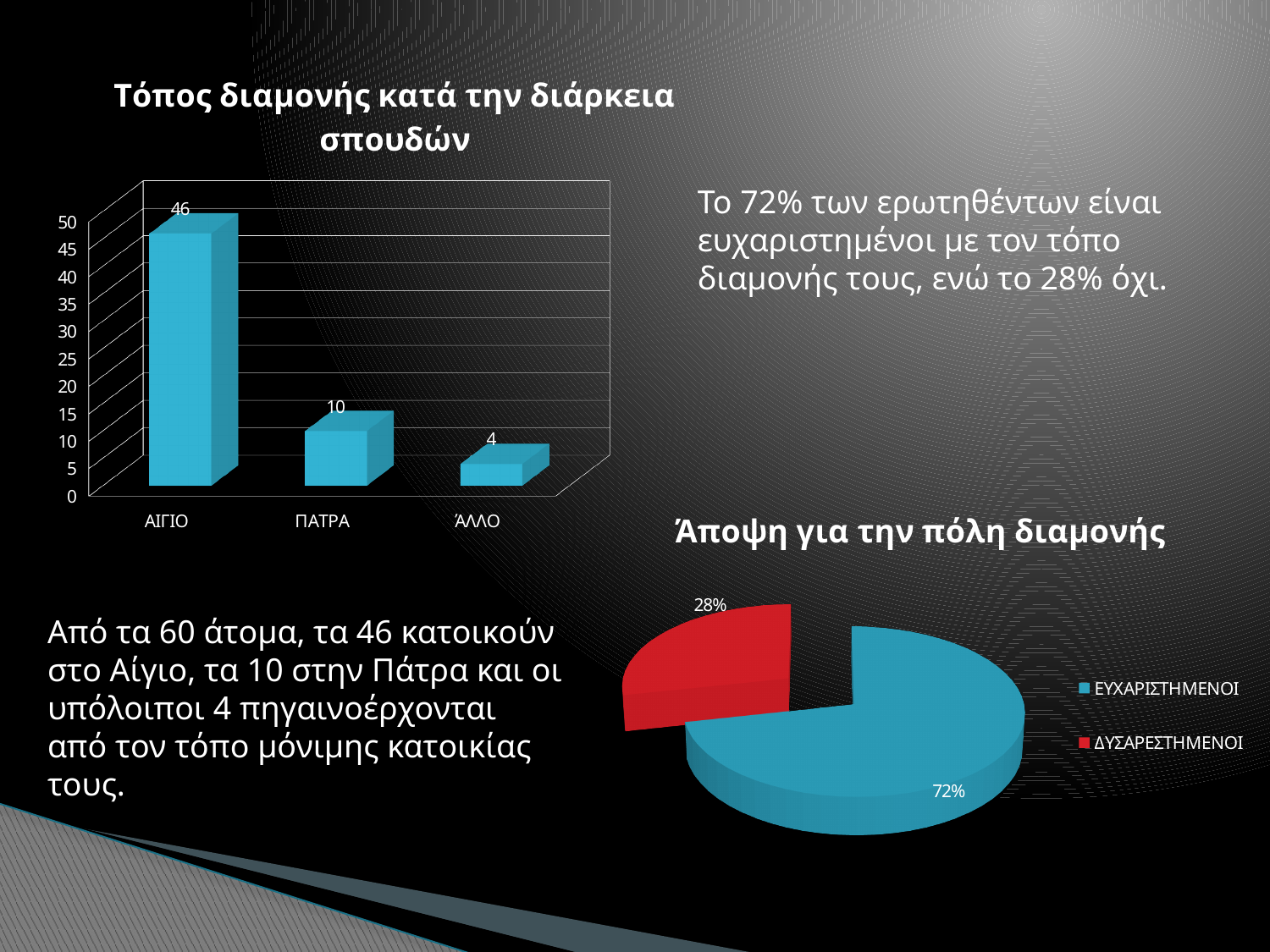
In the pie chart 'Άποψη για την πόλη διαμονής', which slice is larger, ΕΥΧΑΡΙΣΤΗΜΕΝΟΙ or ΔΥΣΑΡΕΣΤΗΜΕΝΟΙ? ΕΥΧΑΡΙΣΤΗΜΕΝΟΙ In the bar chart 'Τόπος διαμονής κατά την διάρκεια σπουδών', which category has the lowest value? ΆΛΛΟ In the pie chart 'Άποψη για την πόλη διαμονής', what colour is the ΔΥΣΑΡΕΣΤΗΜΕΝΟΙ slice? red In the bar chart 'Τόπος διαμονής κατά την διάρκεια σπουδών', what is the value for ΠΑΤΡΑ? 10 In the pie chart 'Άποψη για την πόλη διαμονής', what share is ΕΥΧΑΡΙΣΤΗΜΕΝΟΙ? 72% In the bar chart 'Τόπος διαμονής κατά την διάρκεια σπουδών', what is the difference between the values for ΑΙΓΙΟ and ΠΑΤΡΑ? 36 In the bar chart 'Τόπος διαμονής κατά την διάρκεια σπουδών', what is the value for ΆΛΛΟ? 4 What kind of chart is the chart titled 'Τόπος διαμονής κατά την διάρκεια σπουδών'? bar chart In the bar chart 'Τόπος διαμονής κατά την διάρκεια σπουδών', what is the value for ΑΙΓΙΟ? 46 In the bar chart 'Τόπος διαμονής κατά την διάρκεια σπουδών', how many categories are shown? 3 In the pie chart 'Άποψη για την πόλη διαμονής', what share is ΔΥΣΑΡΕΣΤΗΜΕΝΟΙ? 28% In the bar chart 'Τόπος διαμονής κατά την διάρκεια σπουδών', which category has the highest value? ΑΙΓΙΟ